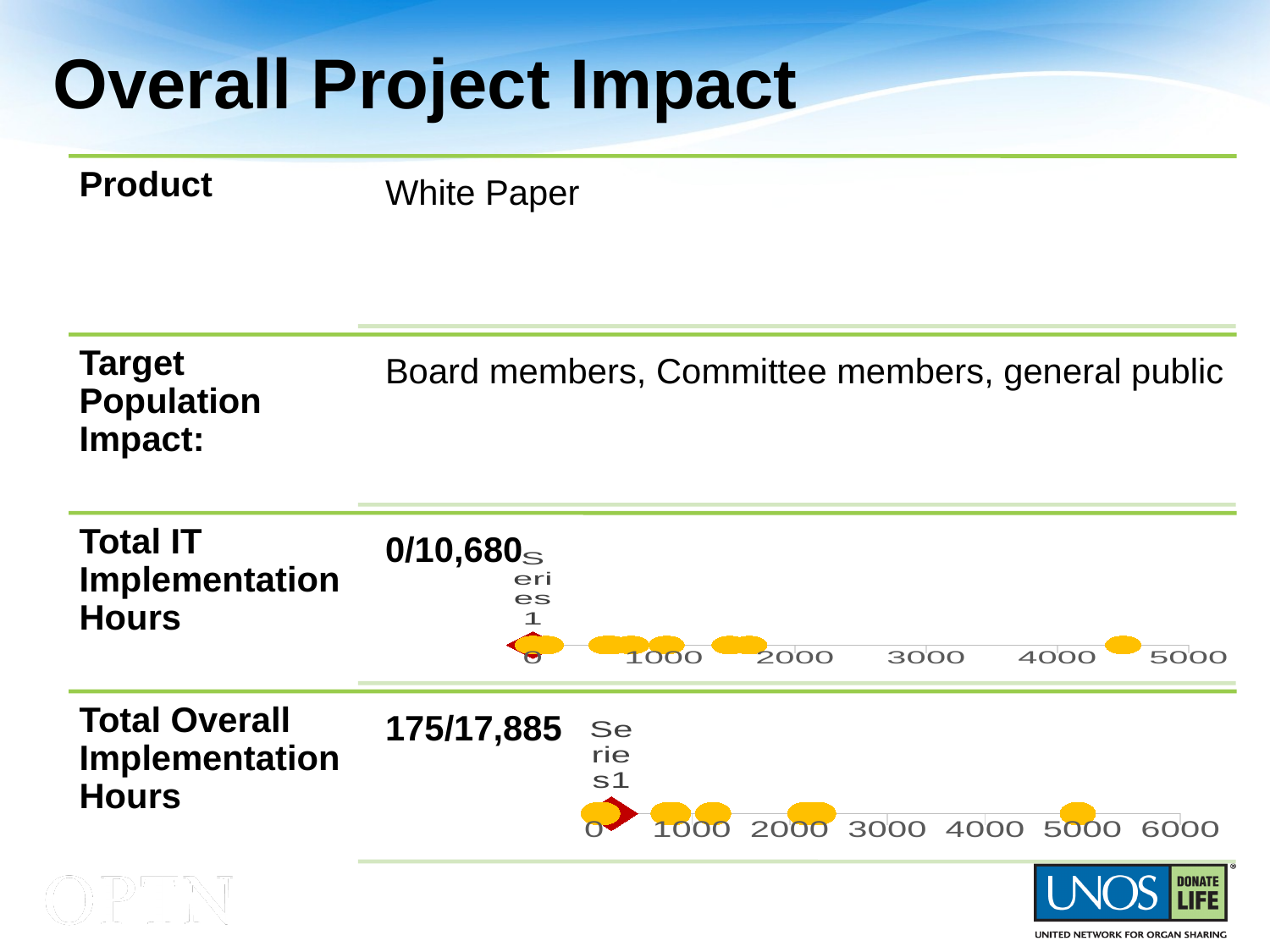
What kind of chart is shown next to "Total Overall Implementation Hours"? scatter chart In the chart next to "Total Overall Implementation Hours", is the rightmost point greater or less than 6000? less In the chart next to "Total Overall Implementation Hours", what is the highest tick value shown on the x axis? 6000 In the chart next to "Total IT Implementation Hours", what is the highest tick value shown on the x axis? 5000 In the chart next to "Total IT Implementation Hours", is the rightmost point greater or less than 5000? less In the chart next to "Total Overall Implementation Hours", is the rightmost point greater or less than 4000? greater What kind of chart is shown next to "Total IT Implementation Hours"? scatter chart